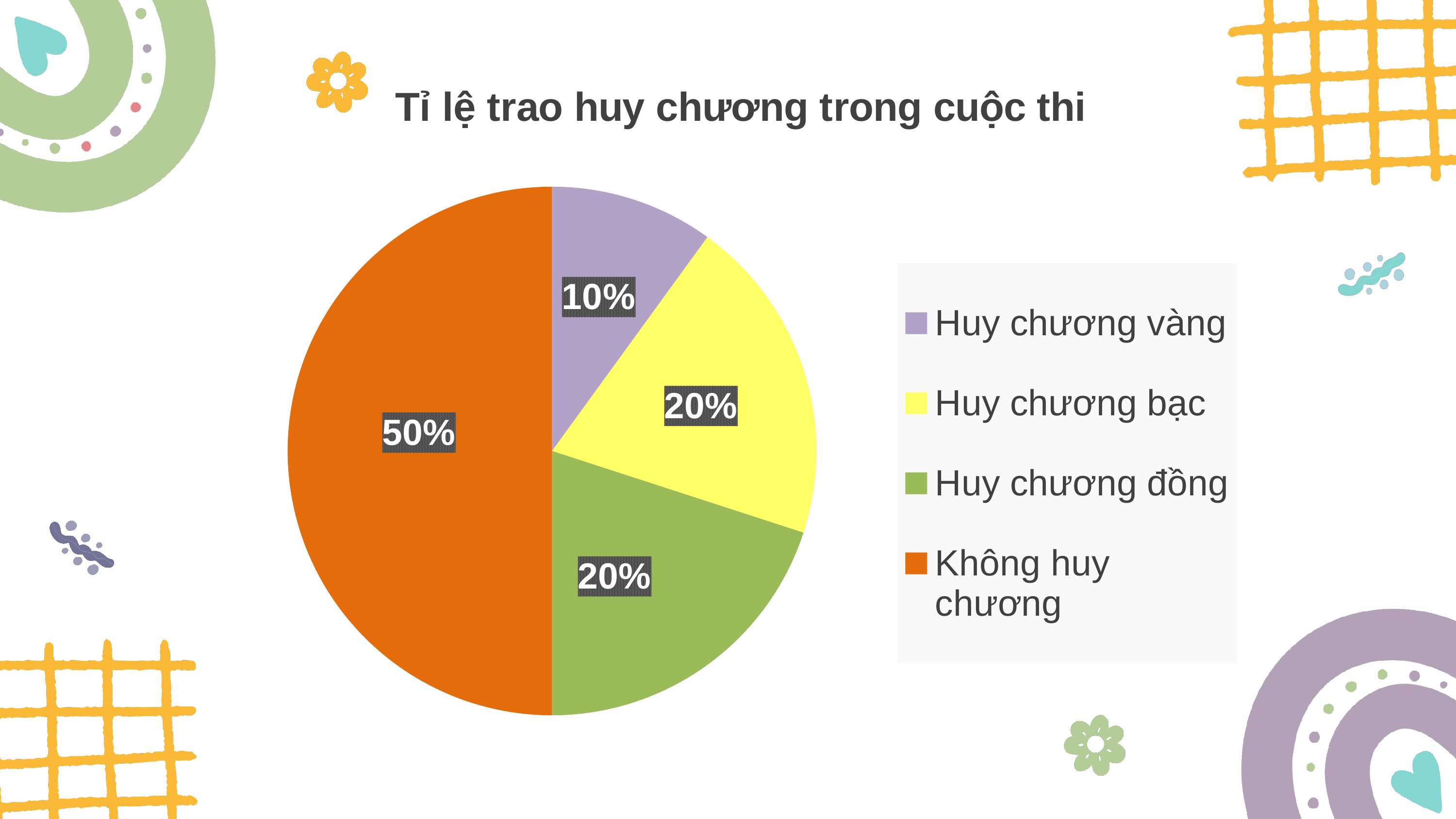
What type of chart is shown on the slide? Pie chart What colour is the slice for 'Không huy chương'? Orange How many slices does the pie chart have? 4 How many entries does the legend list? 4 Which category has the largest share of the pie? Không huy chương What percentage of the pie is 'Không huy chương'? 50% What percentage of the pie is 'Huy chương bạc'? 20% What is the difference between the share for 'Không huy chương' and the share for 'Huy chương vàng'? 40% Which is larger, the share for 'Huy chương đồng' or the share for 'Huy chương vàng'? Huy chương đồng What percentage of the pie is 'Huy chương vàng'? 10% Which category has the smallest share of the pie? Huy chương vàng What is the title of the chart? Tỉ lệ trao huy chương trong cuộc thi